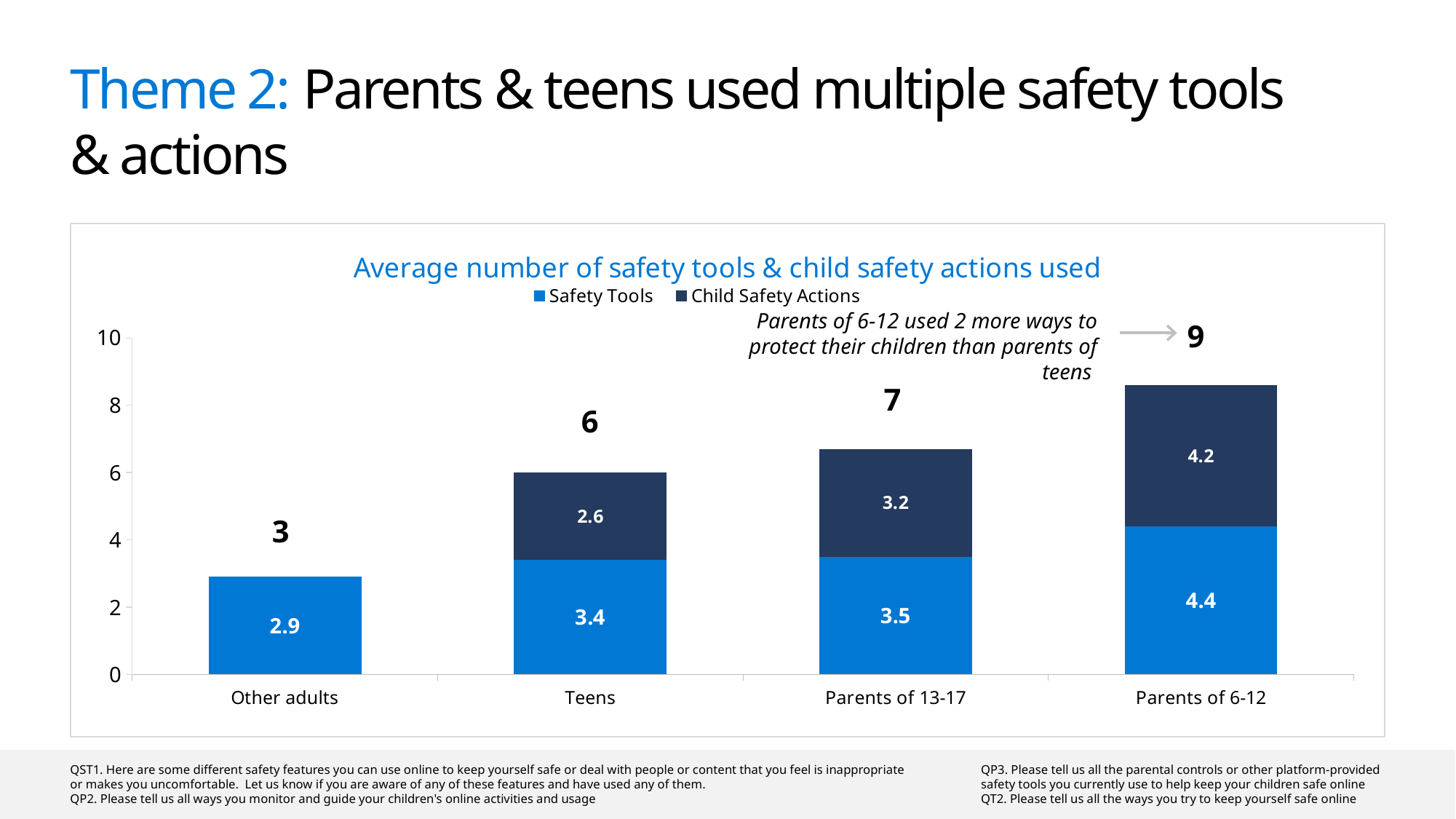
Which is larger, the Child Safety Actions value for Teens or for Parents of 6-12? Parents of 6-12 How many categories are shown on the x axis of the chart? 4 What total is printed above the Parents of 6-12 bar? 9 What is the title of the chart? Average number of safety tools & child safety actions used What is the Safety Tools value for Parents of 6-12? 4.4 Which category has the lowest Child Safety Actions value among those with a Child Safety Actions segment? Teens What type of chart is shown on the slide? Stacked bar chart How many series does the chart legend list? 2 What is the Safety Tools value for Other adults? 2.9 What is the difference between the Safety Tools values for Parents of 6-12 and Other adults? 1.5 Which category has the highest Safety Tools value? Parents of 6-12 What is the Child Safety Actions value for Parents of 13-17? 3.2